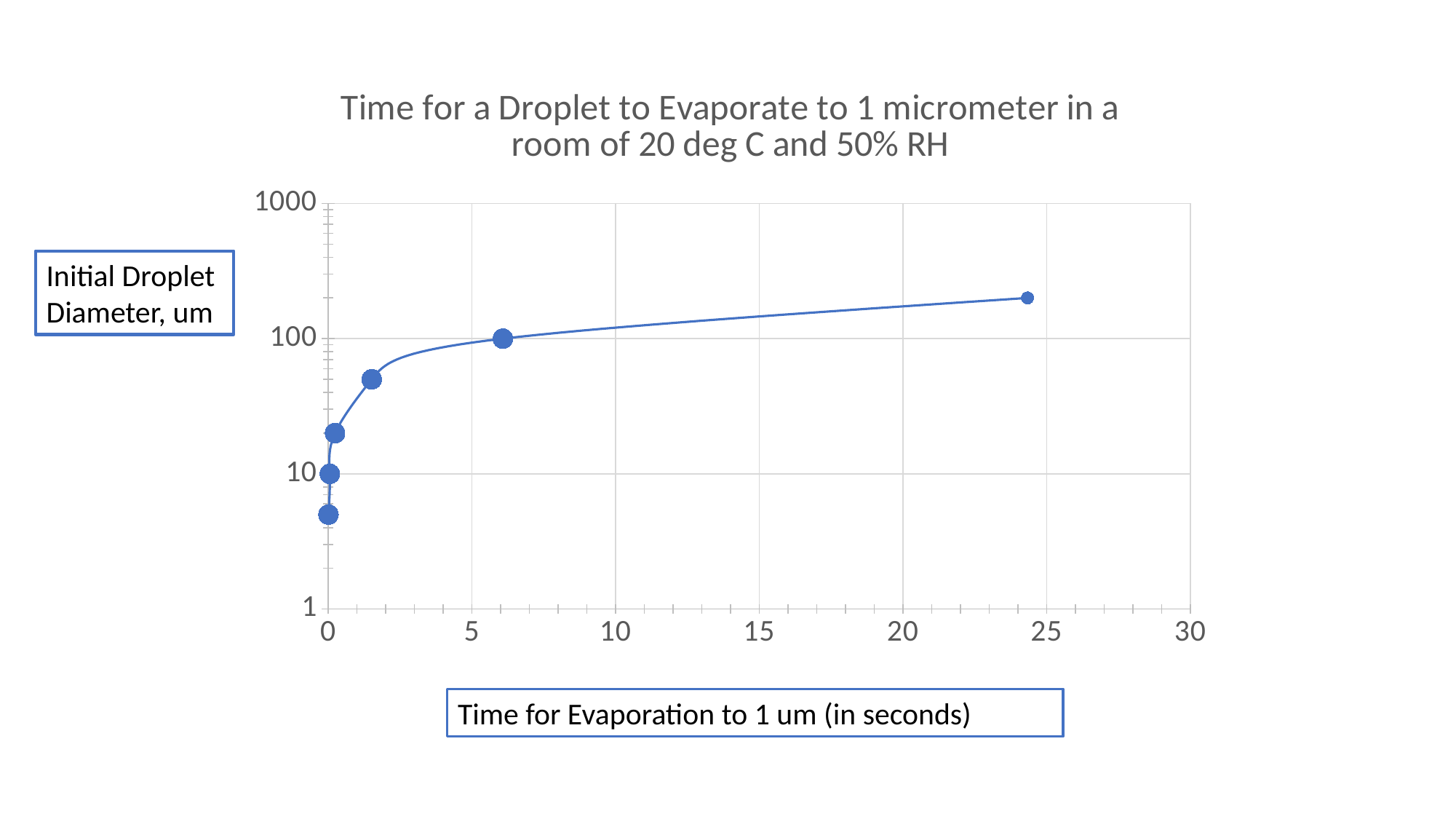
What initial droplet diameter does the point at roughly 6 seconds correspond to? 100 What kind of chart is shown on the slide? Scatter chart with a smoothed line As the time for evaporation increases along the x axis, does the initial droplet diameter rise or fall? Rise Which point has the longest time for evaporation to 1 um: the one with the largest initial diameter or the one with the smallest? The one with the largest initial diameter What is the label of the x axis? Time for Evaporation to 1 um (in seconds) Is the evaporation time for the point with a diameter of 100 um greater or less than 5 seconds? greater What is the title of the chart? Time for a Droplet to Evaporate to 1 micrometer in a room of 20 deg C and 50% RH How many data points are plotted on the chart? 6 Is the initial droplet diameter of the rightmost point greater or less than 100? greater What is the highest value shown on the y axis? 1000 Is the evaporation time for the rightmost point greater or less than 20 seconds? greater